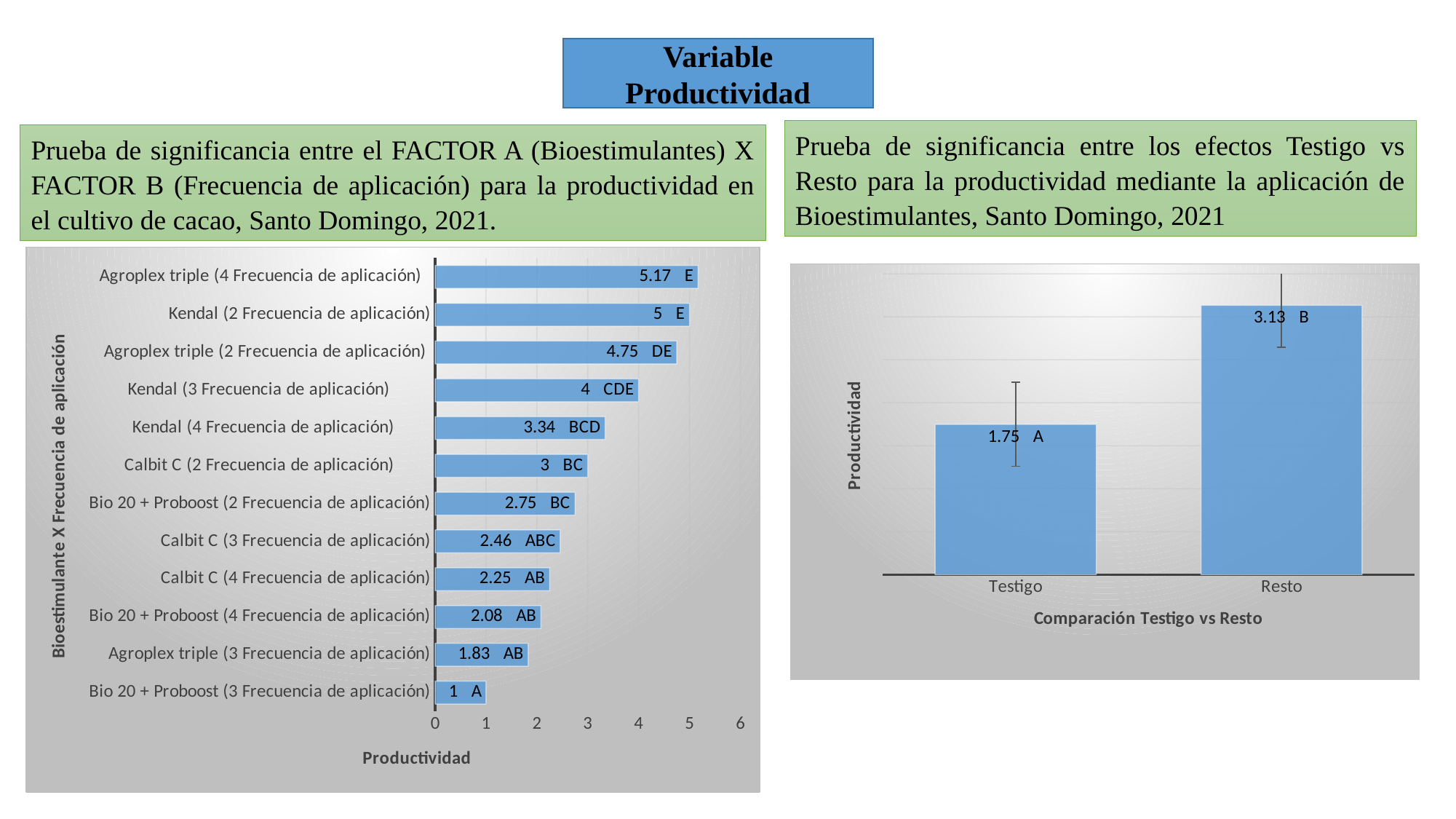
In the right chart (Comparación Testigo vs Resto), what is the difference in productivity between Resto and Testigo? 1.38 In the left chart, which has a higher productivity: Calbit C (3 Frecuencia de aplicación) or Bio 20 + Proboost (4 Frecuencia de aplicación)? Calbit C (3 Frecuencia de aplicación) How many categories are plotted in the left chart? 12 In the left chart, which category has the lowest productivity? Bio 20 + Proboost (3 Frecuencia de aplicación) In the left chart, what is the productivity value for Kendal (4 Frecuencia de aplicación)? 3.34 What is the x-axis title of the right chart? Comparación Testigo vs Resto In the right chart (Comparación Testigo vs Resto), what is the productivity value for Resto? 3.13 In the right chart (Comparación Testigo vs Resto), what is the productivity value for Testigo? 1.75 In the left chart, what is the productivity value for Agroplex triple (4 Frecuencia de aplicación)? 5.17 In the left chart, which category has the highest productivity? Agroplex triple (4 Frecuencia de aplicación) What type of chart is the left chart? Bar chart In the left chart, what is the difference in productivity between Kendal (2 Frecuencia de aplicación) and Calbit C (2 Frecuencia de aplicación)? 2